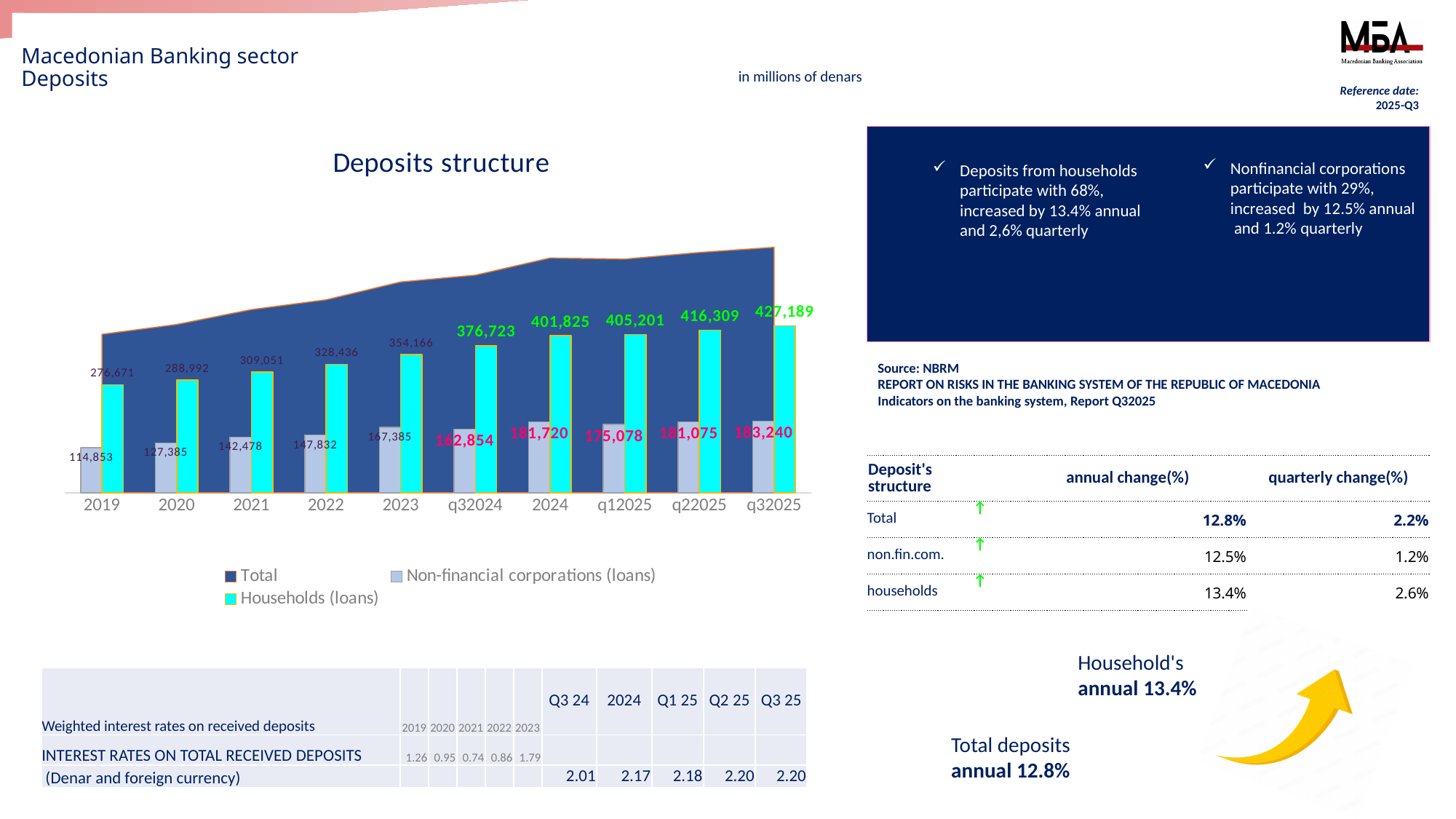
How many series does the legend of the Deposits structure chart list? 3 In the Deposits structure chart, which period has the lowest value for Households (loans)? 2019 In the Deposits structure chart, which period has the highest value for Households (loans)? q32025 In the Deposits structure chart, what is the value for Non-financial corporations (loans) in 2023? 167,385 In the Deposits structure chart, what is the value for Households (loans) in q32025? 427,189 In the Deposits structure chart, what is the value for Non-financial corporations (loans) in 2019? 114,853 How many periods are shown on the x axis of the Deposits structure chart? 10 In the Deposits structure chart, what is the value for Households (loans) in 2019? 276,671 In the Deposits structure chart, which is larger: the Households (loans) value for 2024 or for q12025? q12025 In the Deposits structure chart, what is the difference between the Non-financial corporations (loans) values for 2020 and 2019? 12,532 In the Deposits structure chart, what is the difference between the Households (loans) values for q32025 and q22025? 10,880 In the Deposits structure chart, do the Households (loans) values rise or fall from 2019 to q32025? rise